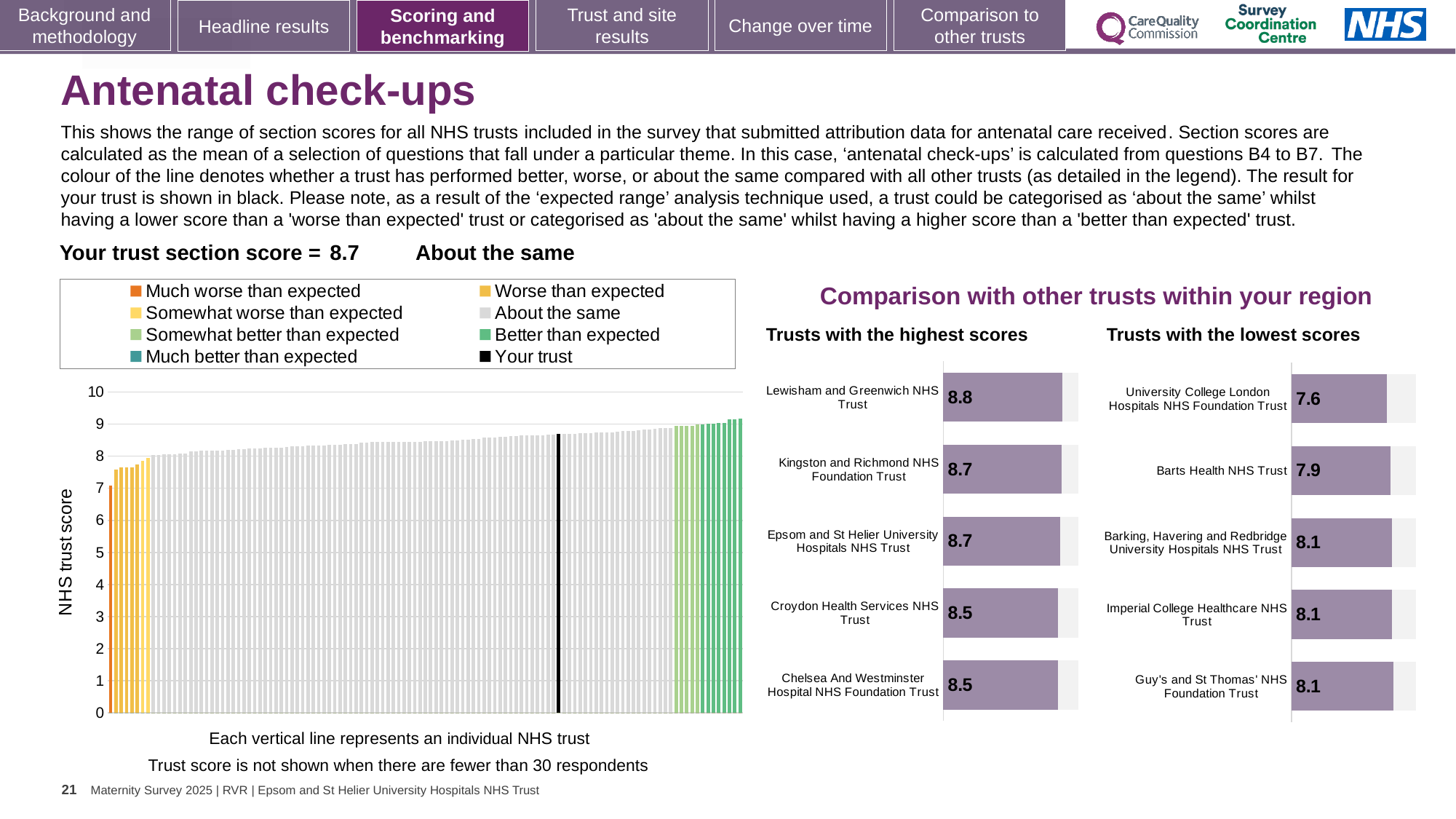
In the 'Trusts with the lowest scores' chart, which trust has the lowest score? University College London Hospitals NHS Foundation Trust What kind of chart is the main chart on the left showing NHS trust scores? bar chart In the 'Trusts with the highest scores' chart, which trust has the highest score? Lewisham and Greenwich NHS Trust In the 'Trusts with the lowest scores' chart, what is the score for University College London Hospitals NHS Foundation Trust? 7.6 In the main chart on the left, do the trust scores rise or fall from left to right? rise In the 'Trusts with the lowest scores' chart, which has the larger score: Barts Health NHS Trust or University College London Hospitals NHS Foundation Trust? Barts Health NHS Trust How many entries does the legend of the main chart on the left list? 8 In the 'Trusts with the highest scores' chart, what is the difference between the scores of Lewisham and Greenwich NHS Trust and Croydon Health Services NHS Trust? 0.3 In the 'Trusts with the highest scores' chart, what is the score for Lewisham and Greenwich NHS Trust? 8.8 How many trusts are shown in the 'Trusts with the lowest scores' chart? 5 In the main chart on the left, is the value for the black 'Your trust' bar greater or less than 8? greater In the 'Trusts with the highest scores' chart, what is the score for Epsom and St Helier University Hospitals NHS Trust? 8.7